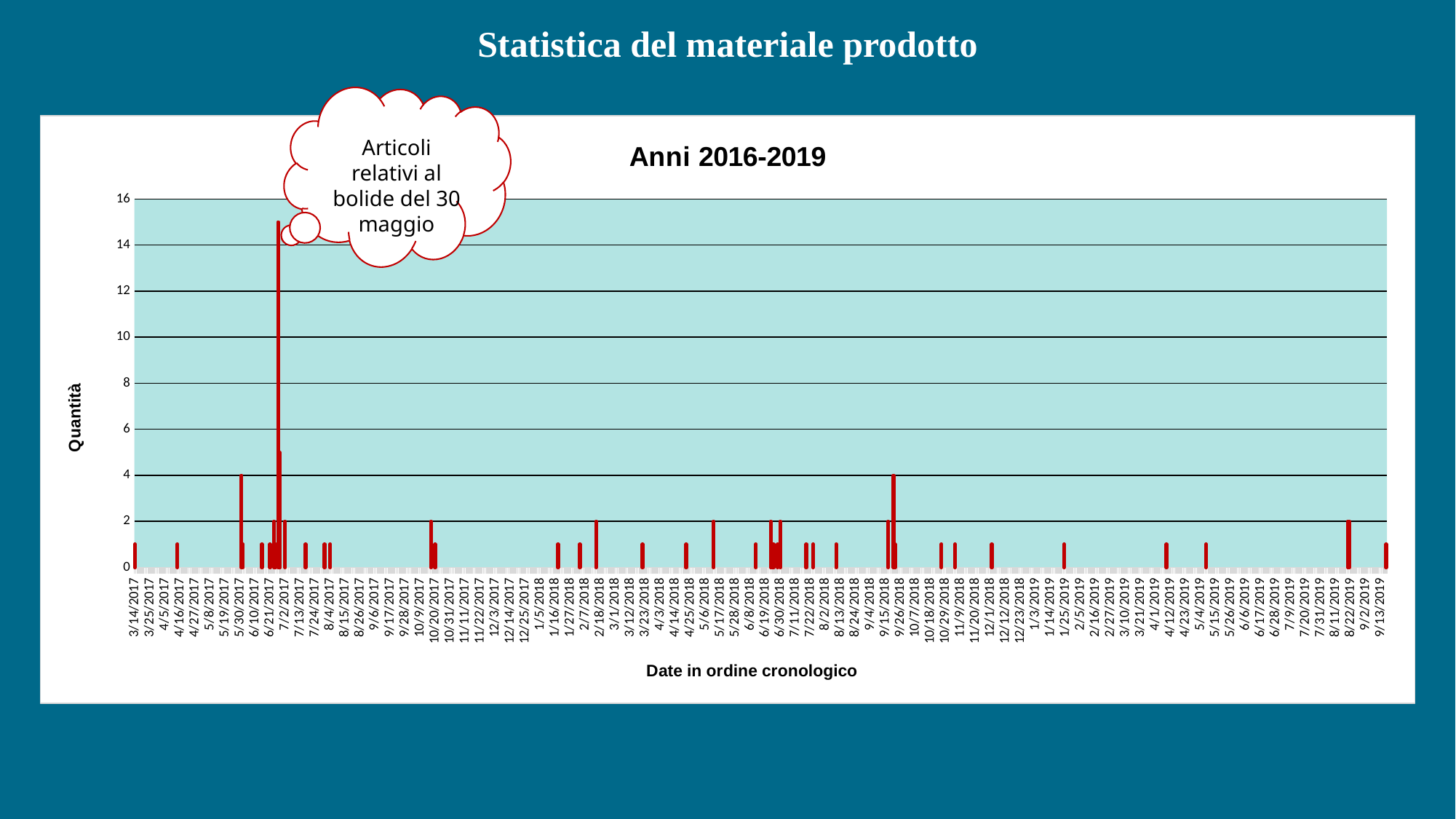
Which is larger: the tallest bar in 2017 or the tallest bar in 2018? the tallest bar in 2017 What is the label of the vertical axis of the chart? Quantità What is the highest value shown on the vertical axis of the chart? 16 What is the last date label on the horizontal axis of the chart? 9/13/2019 What is the first date label on the horizontal axis of the chart? 3/14/2017 What is the title of the chart? Anni 2016-2019 What kind of chart is shown on the slide? bar chart Is the value for 4/16/2017 greater or less than 2? less Is the value for 5/30/2017 greater or less than 2? greater In which year does the tallest bar of the chart occur: 2017, 2018 or 2019? 2017 Is the tallest bar in the chart greater or less than 12? greater